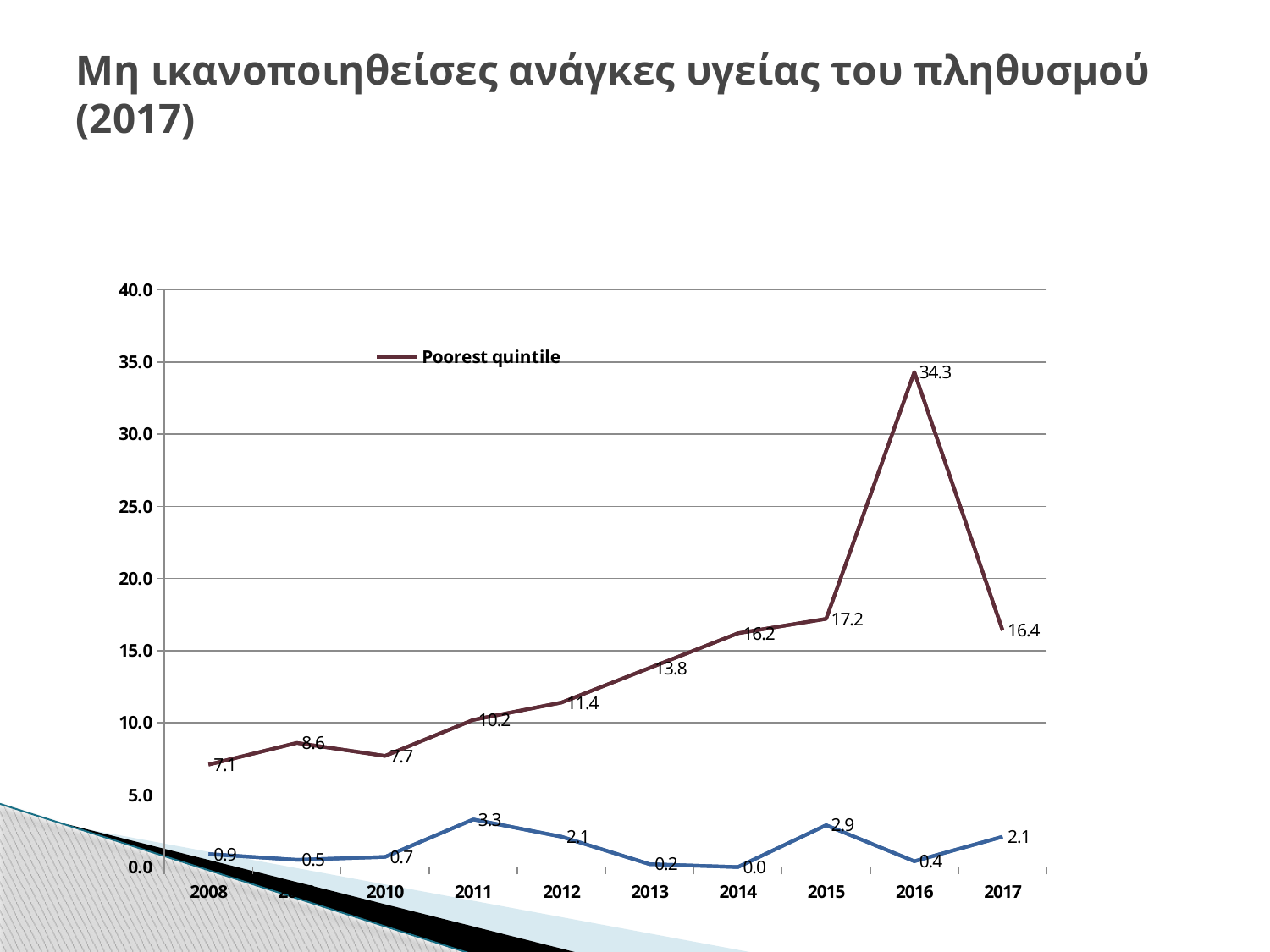
Is the Poorest quintile value in 2015 greater or less than 20.0? less What is the value for Poorest quintile in 2017? 16.4 What is the value for Poorest quintile in 2016? 34.3 What type of chart is shown on the slide? line chart Which is larger for Poorest quintile: the value in 2011 or the value in 2014? 2014 What is the value for Poorest quintile in 2008? 7.1 How many years are shown on the x axis? 10 In which year is the Poorest quintile value lowest? 2008 What is the value for Poorest quintile in 2013? 13.8 How many series does the legend list? 1 What is the difference between the Poorest quintile values in 2016 and 2017? 17.9 In which year is the Poorest quintile value highest? 2016